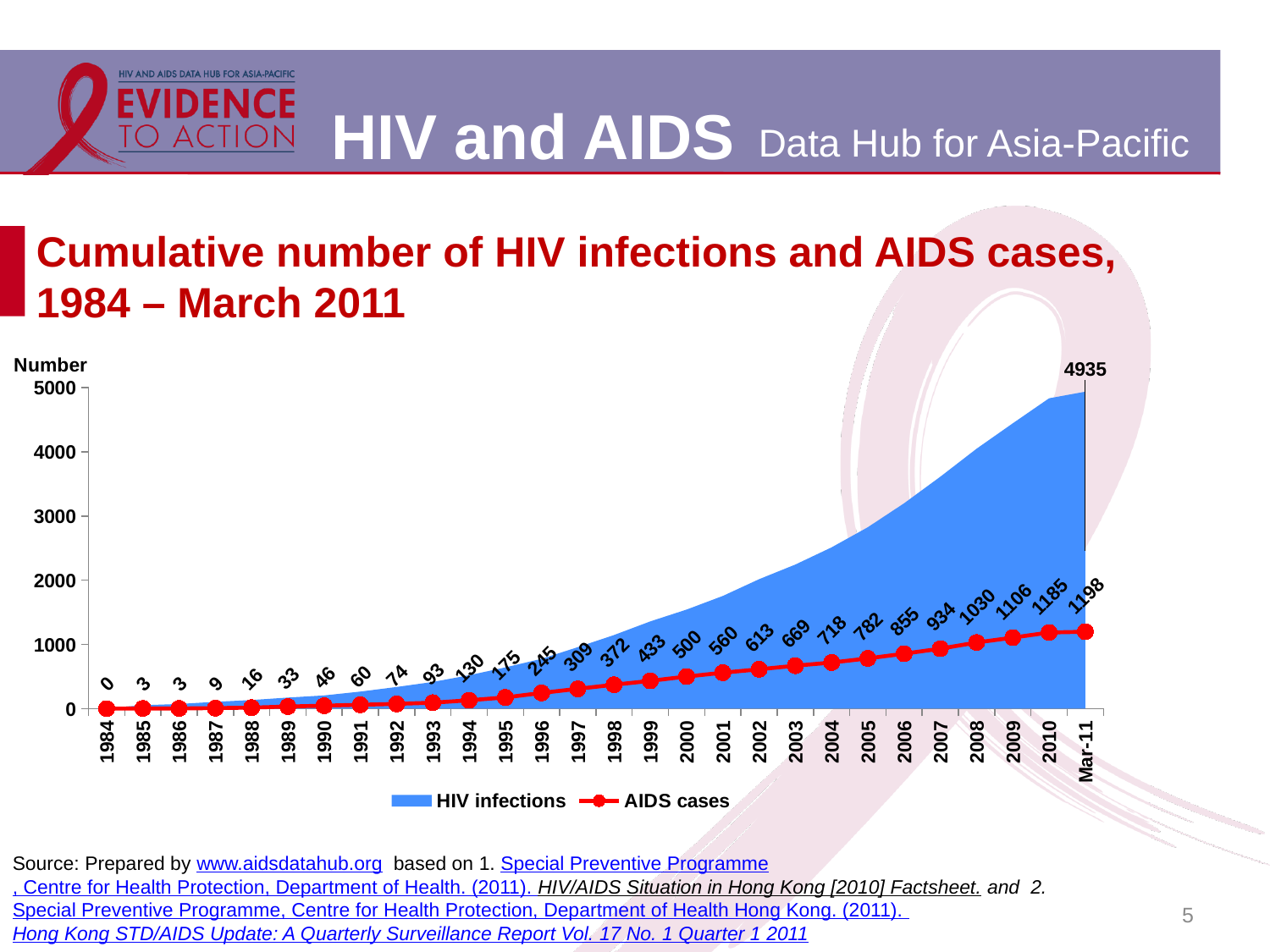
At which point on the x axis is the cumulative number of AIDS cases highest? Mar-11 In which year is the cumulative number of AIDS cases lowest? 1984 Do the cumulative AIDS cases rise or fall from 1984 to Mar-11? rise By how much did the cumulative number of AIDS cases increase from 2009 to 2010? 79 How many series does the legend list? 2 What is the cumulative number of HIV infections at Mar-11? 4935 What is the difference between the cumulative HIV infections and AIDS cases at Mar-11? 3737 What is the cumulative number of AIDS cases in 1994? 130 What is the cumulative number of AIDS cases in 2000? 500 Is the cumulative number of HIV infections in 2005 greater or less than 2000? greater How many time points are shown on the x axis? 28 Which is larger, the cumulative AIDS cases in 1996 or in 1995? 1996